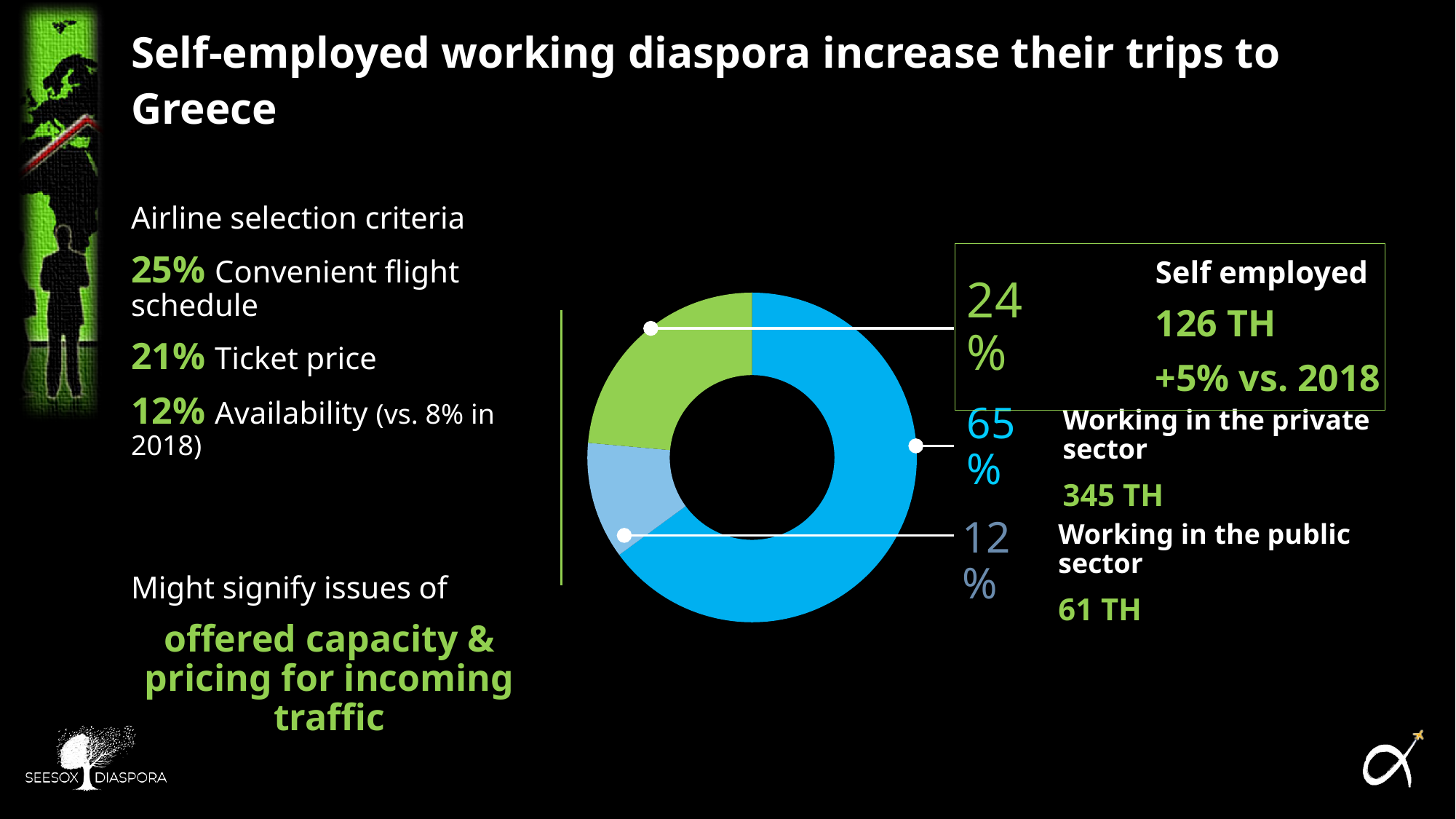
What percentage of the donut chart is labelled 'Self employed'? 24% Which category has the largest slice in the donut chart? Working in the private sector How many thousand people are shown for the 'Working in the private sector' slice? 345 TH What percentage of the donut chart is labelled 'Working in the private sector'? 65% How many thousand people are shown for the 'Self employed' slice? 126 TH Which slice is larger: 'Self employed' or 'Working in the public sector'? Self employed What is the difference in percentage points between the 'Working in the private sector' slice and the 'Self employed' slice? 41 Which category has the smallest slice in the donut chart? Working in the public sector How many slices does the donut chart have? 3 What kind of chart is shown on the slide? Donut (pie) chart What colour is the 'Working in the private sector' slice of the donut chart? Blue What percentage of the donut chart is labelled 'Working in the public sector'? 12%